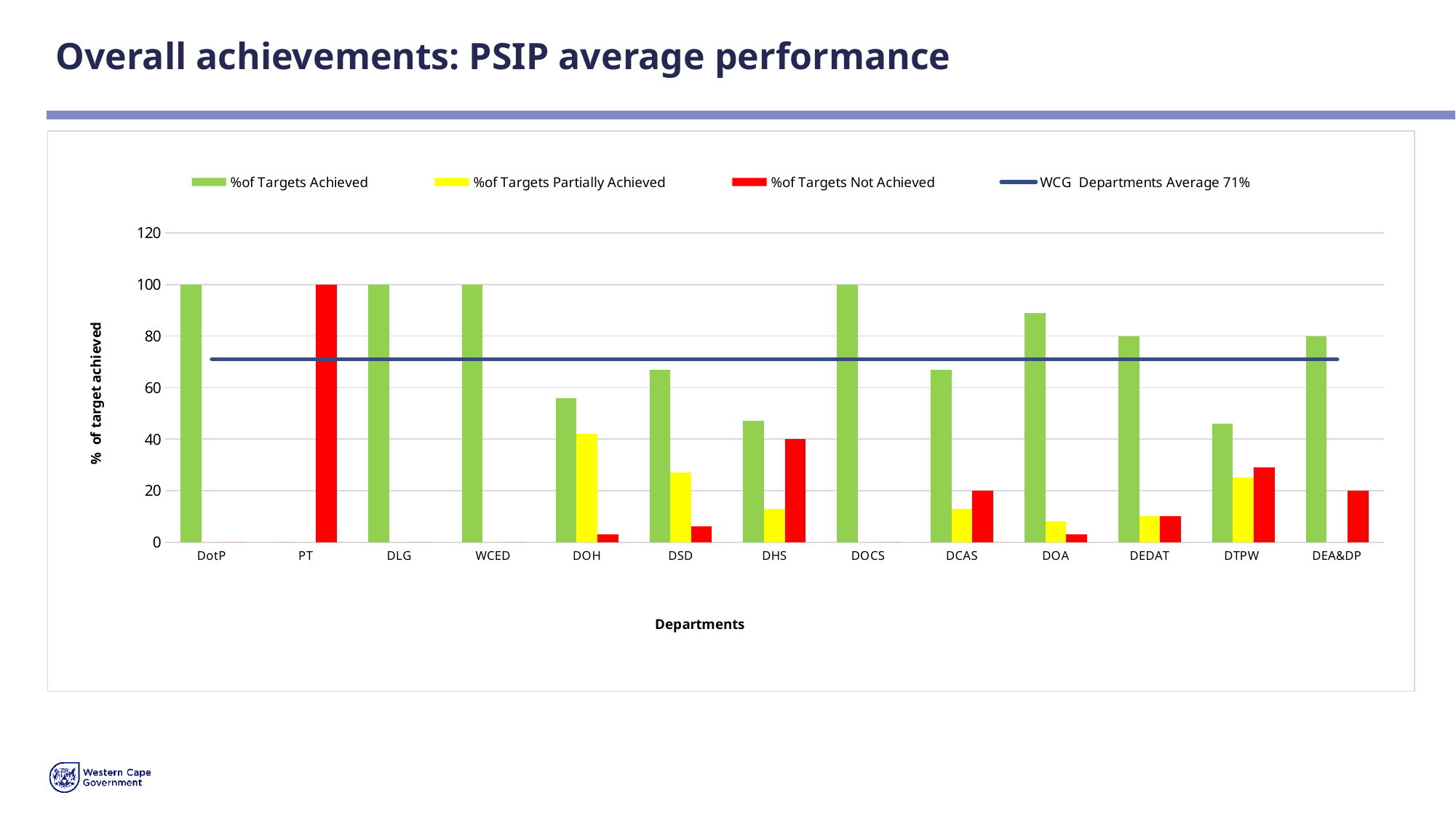
Which department has the highest % of Targets Not Achieved? PT What is the % of Targets Achieved value for DotP? 100 What is the % of Targets Not Achieved value for PT? 100 What is the % of Targets Not Achieved value for DHS? 40 Which department has the highest % of Targets Partially Achieved? DOH What is the % of Targets Not Achieved value for DEA&DP? 20 How many series does the legend list? 4 What kind of chart is shown on the slide? bar chart Which has the larger % of Targets Achieved, DOH or DSD? DSD How many departments are shown on the x axis? 13 Is the % of Targets Achieved value for DOH greater or less than 60? less What is the WCG Departments Average value given in the legend? 71%